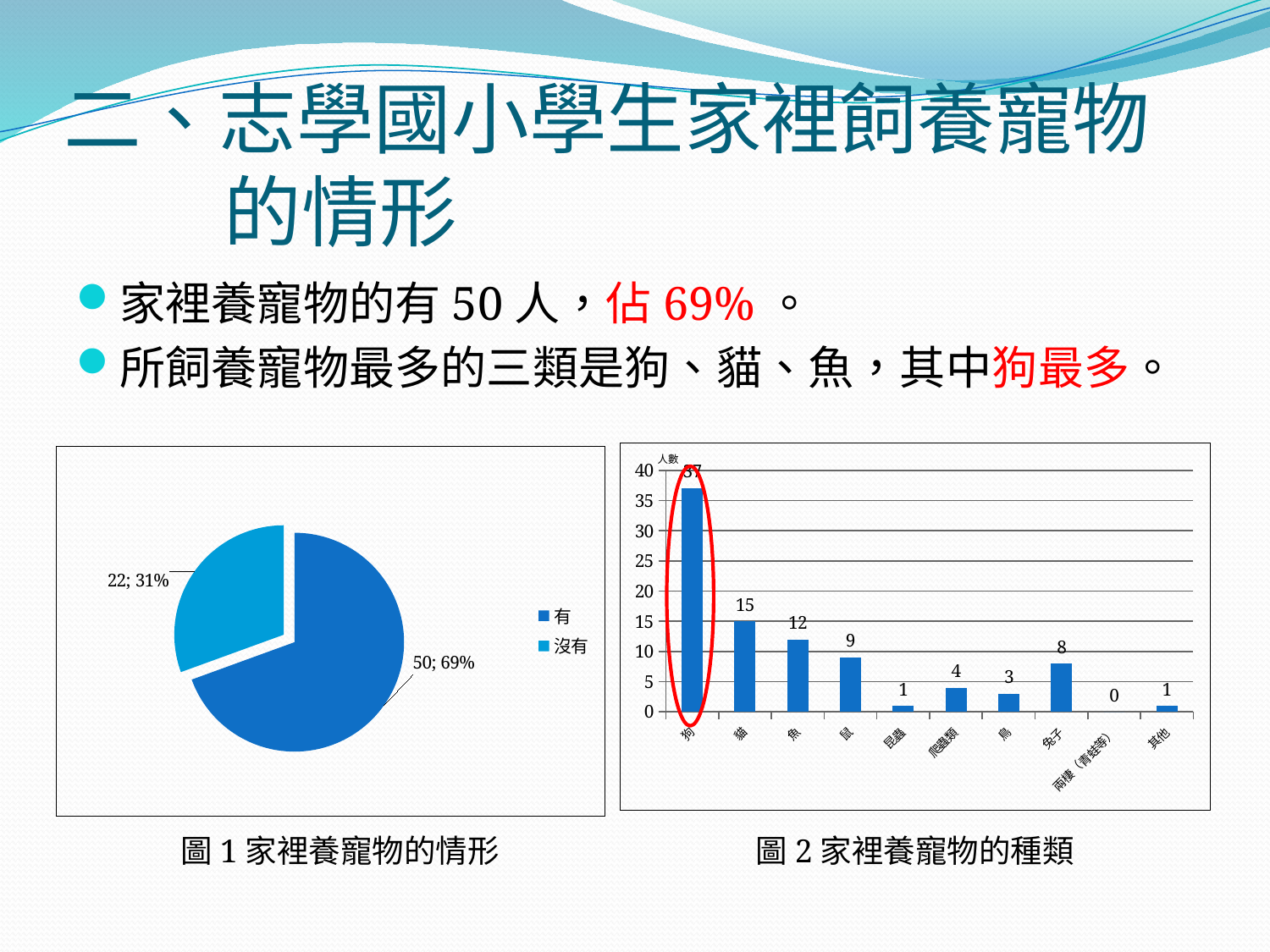
In the bar chart 圖2 家裡養寵物的種類, is the value for 狗 greater or less than 35? greater In the bar chart 圖2 家裡養寵物的種類, what is the difference between the values for 貓 and 魚? 3 In the bar chart 圖2 家裡養寵物的種類, what is the value for 貓? 15 In the pie chart 圖1 家裡養寵物的情形, what share of the pie does 沒有 take? 31% What kind of chart is 圖1 家裡養寵物的情形? Pie chart What kind of chart is 圖2 家裡養寵物的種類? Bar chart In the pie chart 圖1 家裡養寵物的情形, how many entries does the legend list? 2 In the bar chart 圖2 家裡養寵物的種類, what is the value for 兔子? 8 In the bar chart 圖2 家裡養寵物的種類, which category has the lowest value? 兩棲（青蛙等） In the pie chart 圖1 家裡養寵物的情形, what value and percentage are shown for 沒有? 22; 31% In the pie chart 圖1 家裡養寵物的情形, what value and percentage are shown for 有? 50; 69% In the bar chart 圖2 家裡養寵物的種類, which category has the highest value? 狗